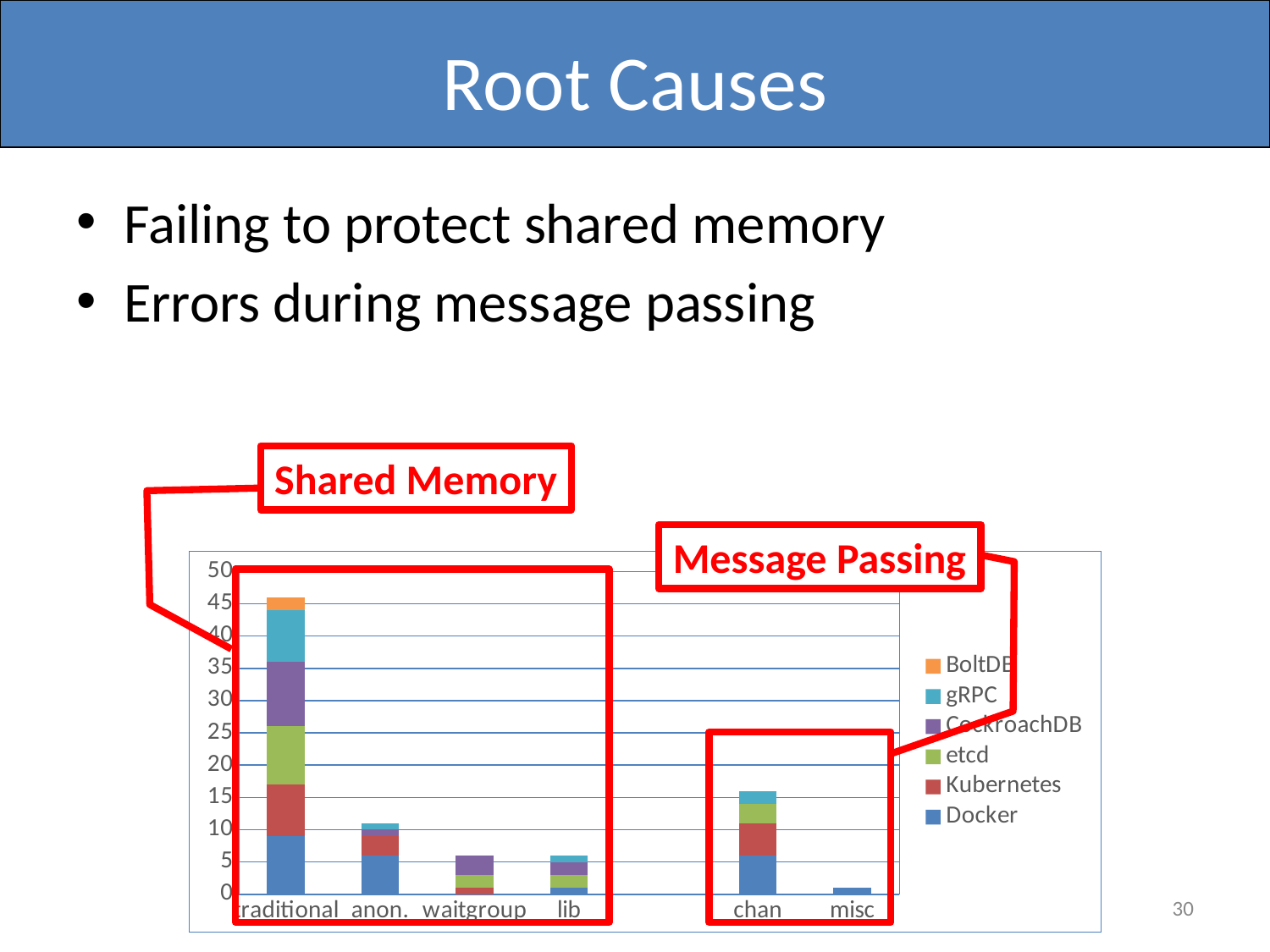
Which series appears at the bottom of each stacked bar? Docker Is the total for the traditional bar greater or less than 40? greater Which two categories are grouped under the 'Message Passing' label? chan and misc Which category has the shortest stacked bar? misc Is the total for the misc bar greater or less than 5? less Which stacked bar is taller, chan or lib? chan What kind of chart is shown on the slide? stacked bar chart Which category has the tallest stacked bar? traditional How many categories are shown along the x axis of the chart? 6 Is the total for the chan bar greater or less than 20? less How many series does the chart's legend list? 6